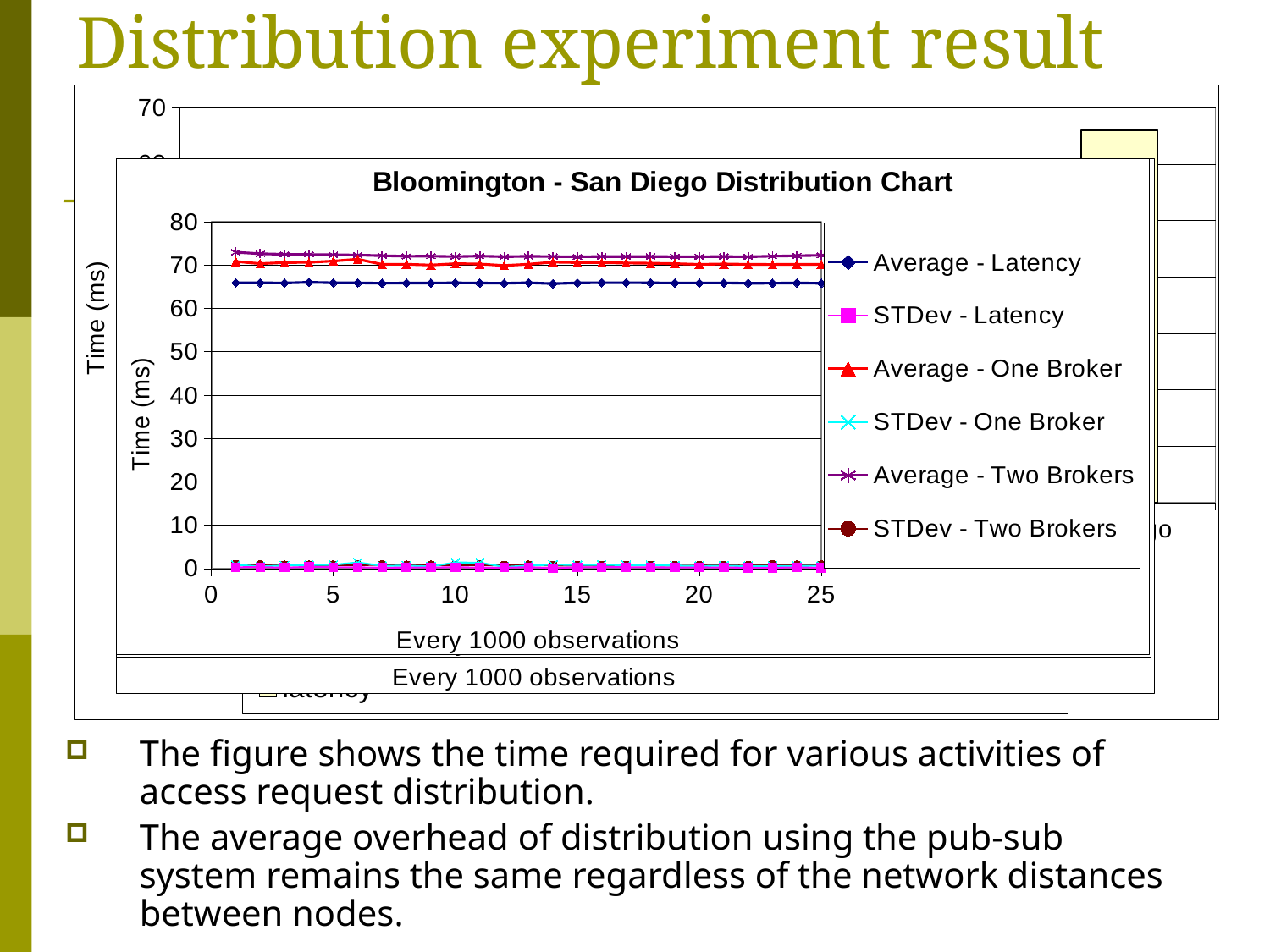
In the Bloomington - San Diego Distribution Chart, is the value for STDev - Two Brokers greater or less than 20? less In the Bloomington - San Diego Distribution Chart, is the value for Average - Two Brokers greater or less than 50? greater In the Bloomington - San Diego Distribution Chart, which is larger, Average - Two Brokers or Average - Latency? Average - Two Brokers What kind of chart is the Bloomington - San Diego Distribution Chart? line chart What is the x-axis label of the Bloomington - San Diego Distribution Chart? Every 1000 observations How many series does the legend of the Bloomington - San Diego Distribution Chart list? 6 What is the title of the front chart on the slide? Bloomington - San Diego Distribution Chart In the Bloomington - San Diego Distribution Chart, which is larger, Average - One Broker or STDev - One Broker? Average - One Broker In the Bloomington - San Diego Distribution Chart, is the value for Average - Latency greater or less than 60? greater In the Bloomington - San Diego Distribution Chart, does the Average - Latency series rise, fall, or stay roughly constant along the x axis? stays roughly constant